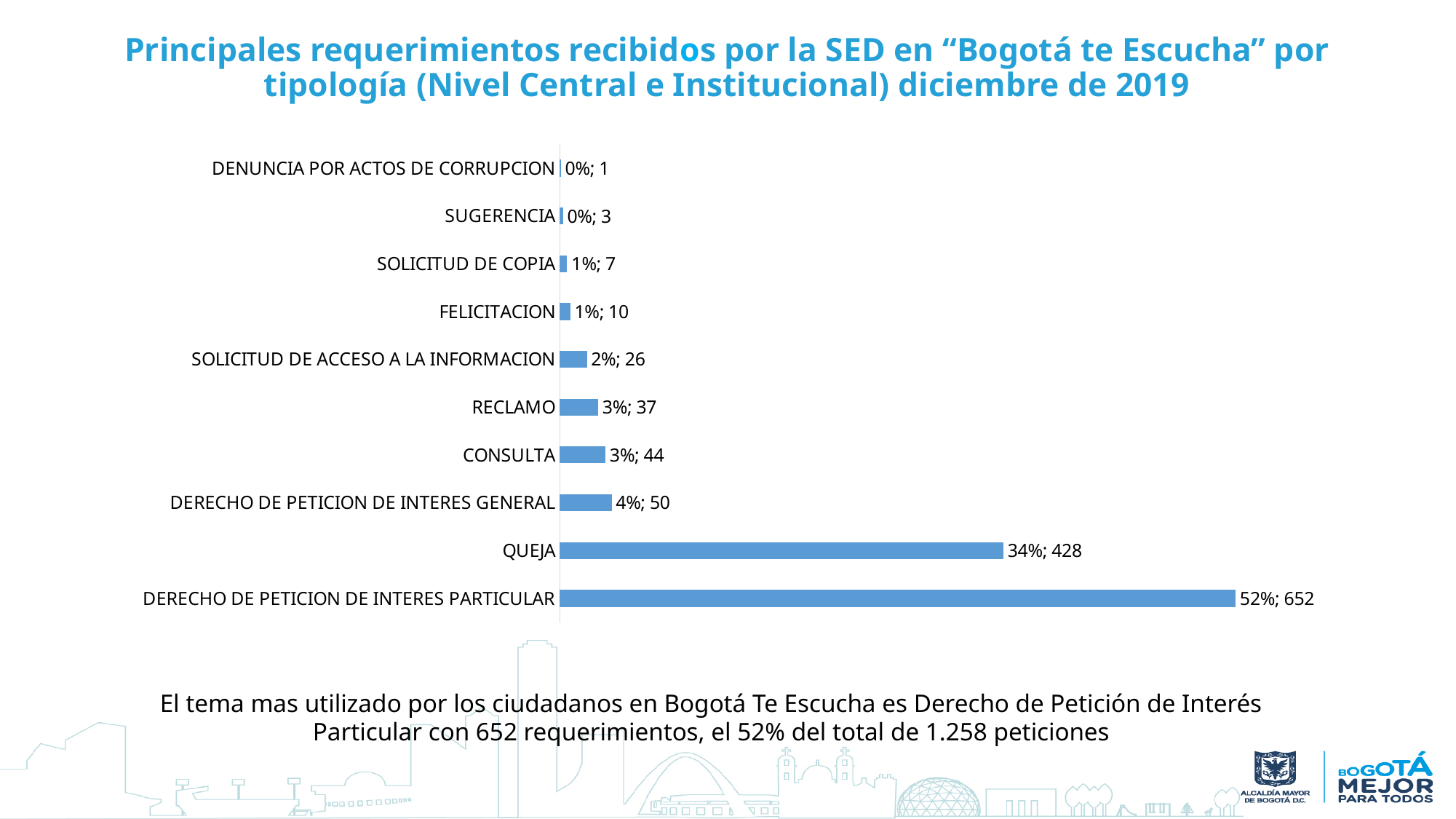
How many categories does the chart show? 10 What is the difference in requests between FELICITACION and SOLICITUD DE COPIA? 3 How many requests are shown for SOLICITUD DE ACCESO A LA INFORMACION? 26 What is the difference in requests between DERECHO DE PETICION DE INTERES PARTICULAR and QUEJA? 224 What colour are the bars in the chart? Blue Which category has the highest number of requests? DERECHO DE PETICION DE INTERES PARTICULAR Which has more requests, CONSULTA or RECLAMO? CONSULTA What percentage share is shown for QUEJA? 34% How many requests does the chart show for QUEJA? 428 What percentage share is shown for DERECHO DE PETICION DE INTERES GENERAL? 4% Which category has the lowest number of requests? DENUNCIA POR ACTOS DE CORRUPCION What kind of chart is shown on the slide? Bar chart